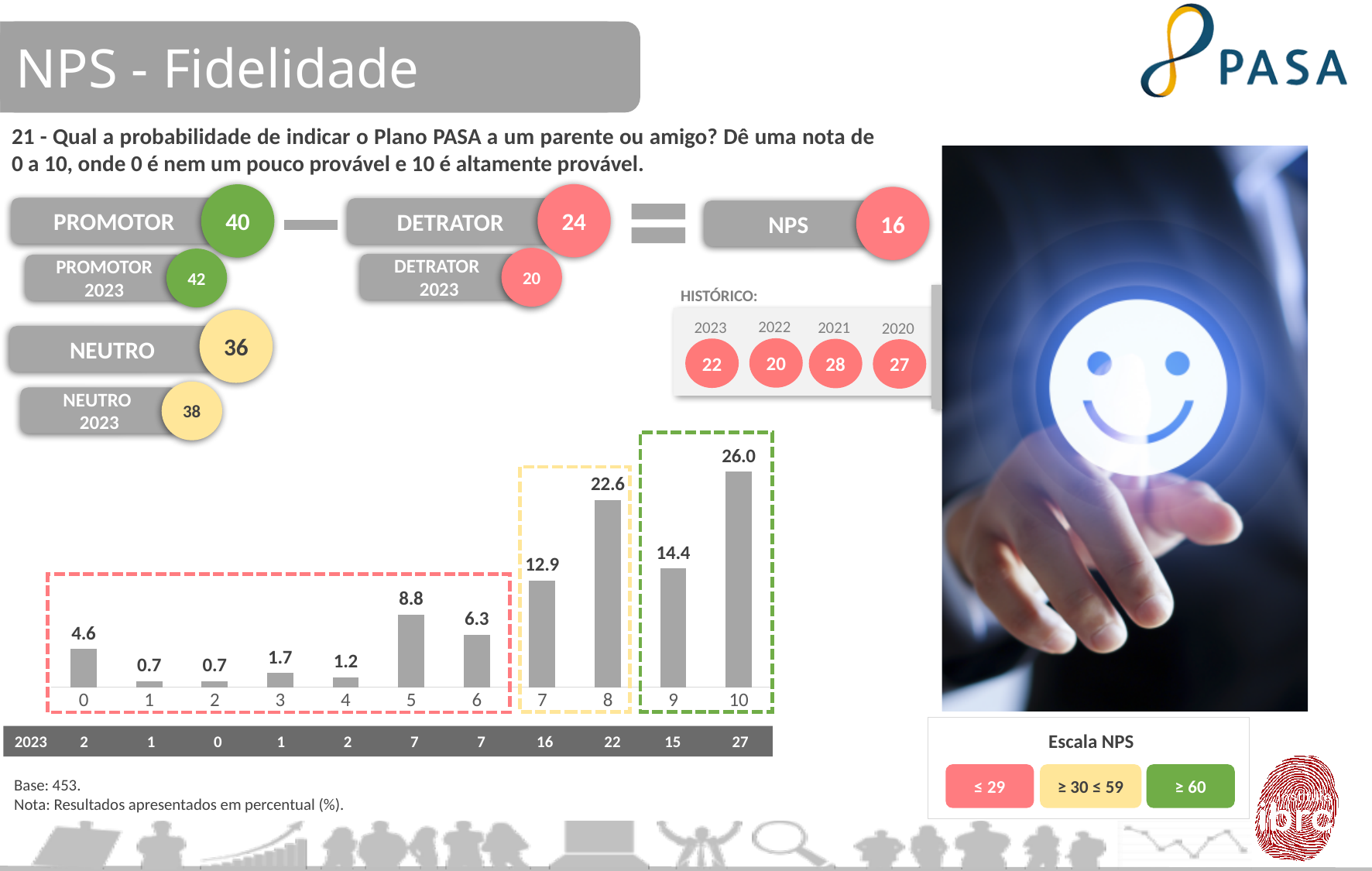
Which score has the lowest value in the bar chart? 1 and 2 (both 0.7) In the 2023 row below the bar chart, what is the value for score 10? 27 What is the value of the bar for score 8 in the bar chart? 22.6 Which score has the highest bar in the bar chart? 10 What kind of chart is used to show the distribution of scores 0 to 10? bar chart How many score categories are shown on the x axis of the bar chart? 11 What is the value of the bar for score 10 in the bar chart? 26.0 What is the difference between the bar for score 0 and the bar for score 6? 1.7 Which is larger in the bar chart, the bar for score 7 or the bar for score 9? score 9 What is the total of the bars for scores 9 and 10 (the green dashed group)? 40.4 What is the difference between the bars for score 10 and score 8? 3.4 What is the value of the bar for score 5 in the bar chart? 8.8